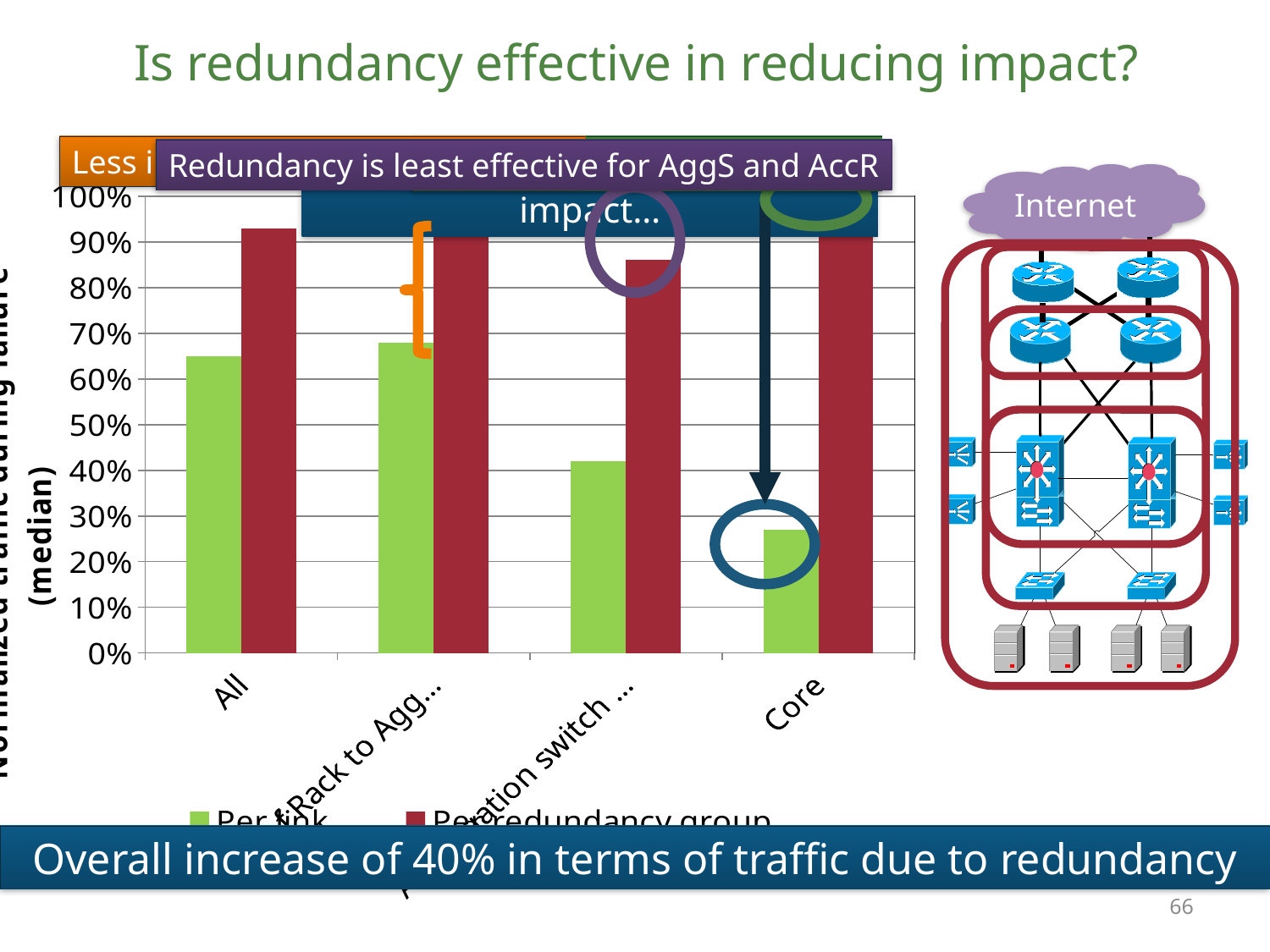
For the All category, which series has the larger value, Per link or Per redundancy group? Per redundancy group What colour are the Per link bars in the chart? green Is the Per link value for All greater or less than 70%? less Is the Per link value for Core greater or less than 30%? less Is the Per redundancy group value for All greater or less than 90%? greater What kind of chart is shown on the slide? bar chart Which has the larger Per link value, All or Core? All How many categories are shown on the x axis of the chart? 4 How many series does the chart's legend list? 2 Which category has the lowest Per link value? Core